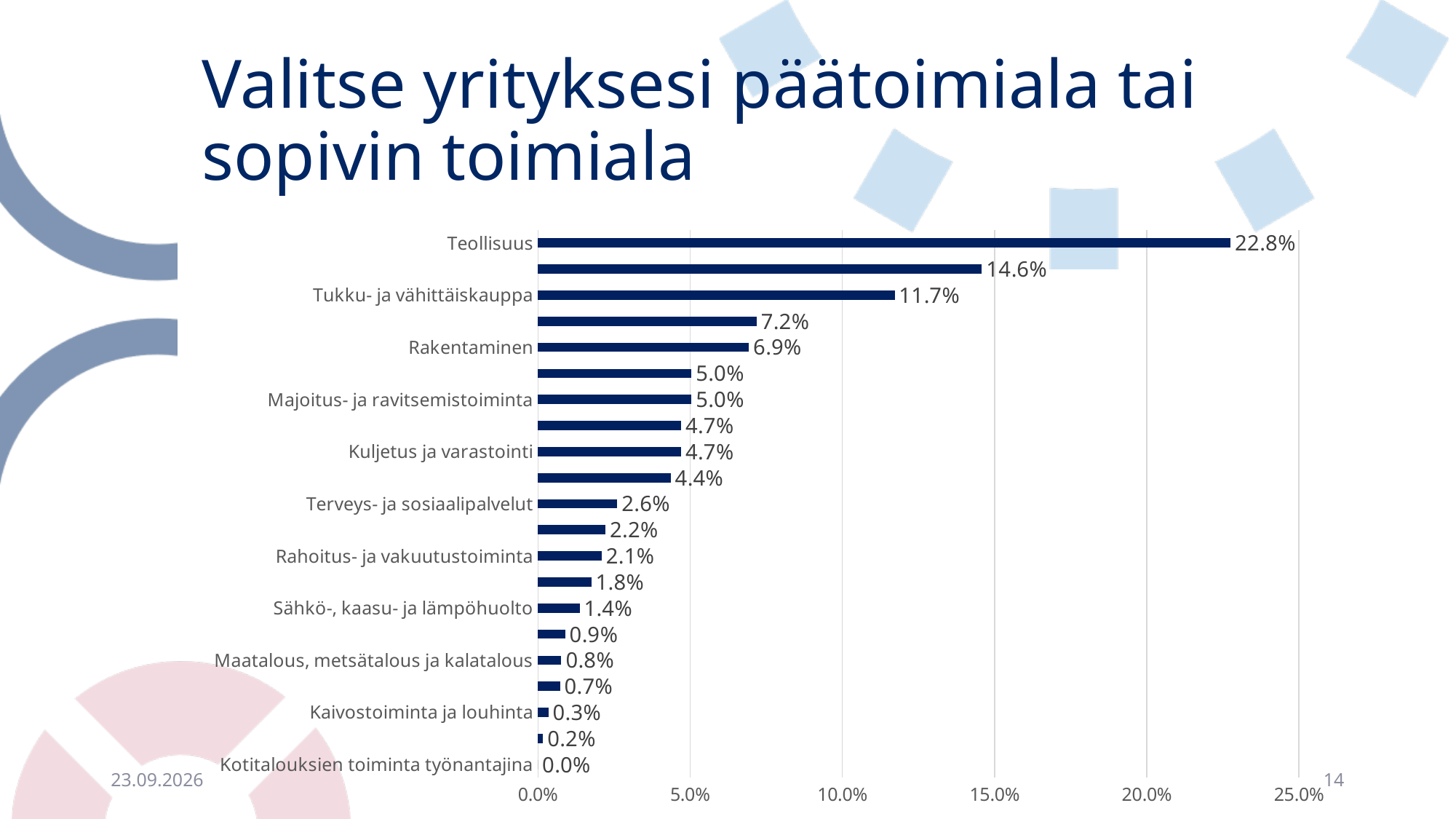
How many bars are plotted in the chart? 21 Which category has the lowest value? Kotitalouksien toiminta työnantajina Is the value for Terveys- ja sosiaalipalvelut greater or less than 5.0%? less What is the value for Teollisuus? 22.8% What is the difference between the values for Teollisuus and Tukku- ja vähittäiskauppa? 11.1% What is the value for Tukku- ja vähittäiskauppa? 11.7% What is the value for Kaivostoiminta ja louhinta? 0.3% Which category has the highest value? Teollisuus What is the value for Kuljetus ja varastointi? 4.7% What is the value for Rakentaminen? 6.9% Which is larger, the value for Rakentaminen or the value for Majoitus- ja ravitsemistoiminta? Rakentaminen What kind of chart is shown on the slide? bar chart